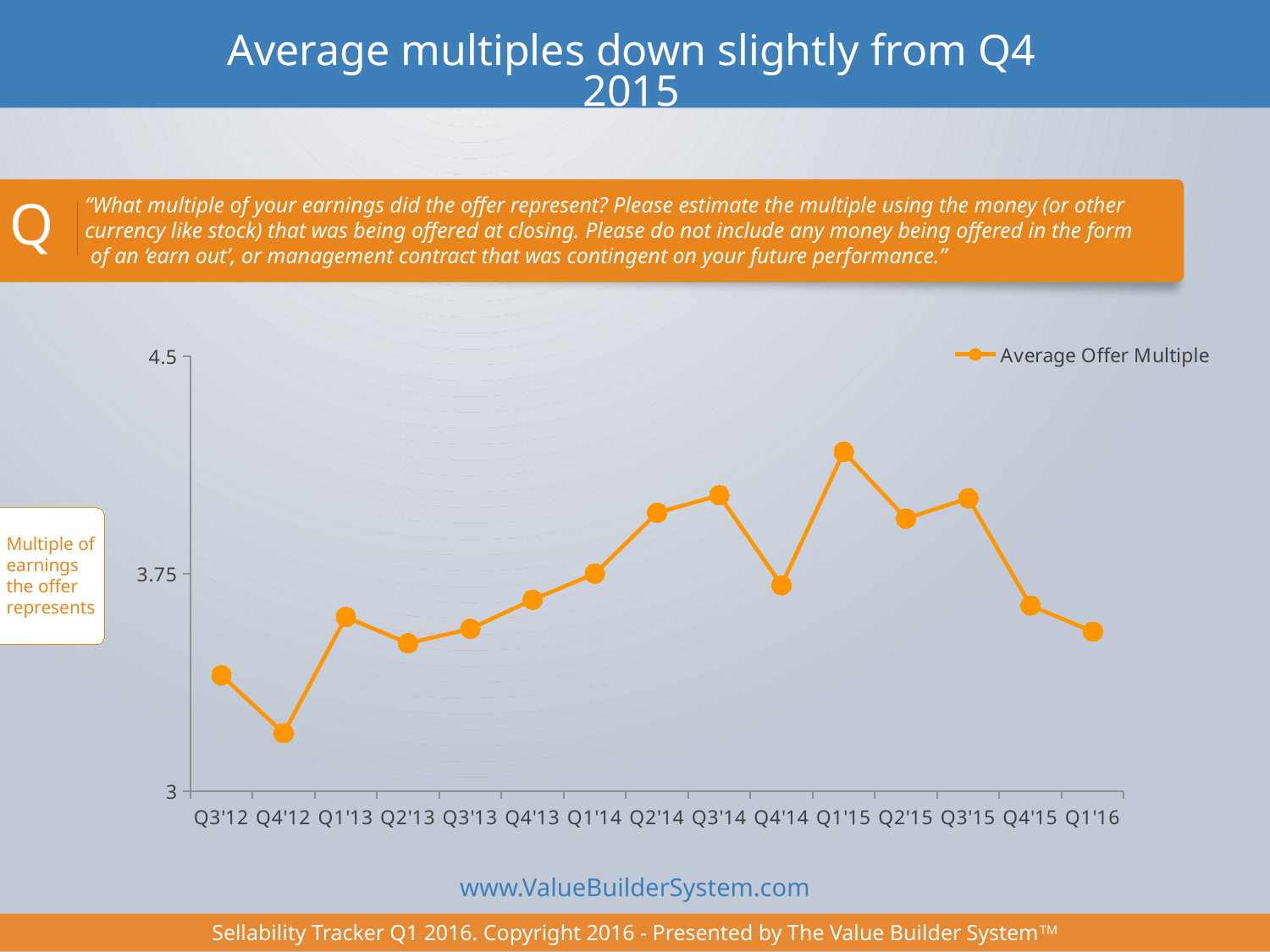
What kind of chart is shown on the slide? line chart Is the Average Offer Multiple for Q1'16 greater or less than 3.75? less Which is larger, the Average Offer Multiple for Q3'12 or for Q4'12? Q3'12 How many series does the chart's legend list? 1 Is the Average Offer Multiple for Q4'12 greater or less than 3.75? less What is the name of the series shown in the chart's legend? Average Offer Multiple Does the Average Offer Multiple rise or fall from Q3'15 to Q1'16? fall Which quarter has the lowest Average Offer Multiple? Q4'12 Which quarter has the highest Average Offer Multiple? Q1'15 How many quarters are plotted on the x axis of the chart? 15 Which is larger, the Average Offer Multiple for Q1'15 or for Q4'15? Q1'15 Is the Average Offer Multiple for Q1'15 greater or less than 3.75? greater